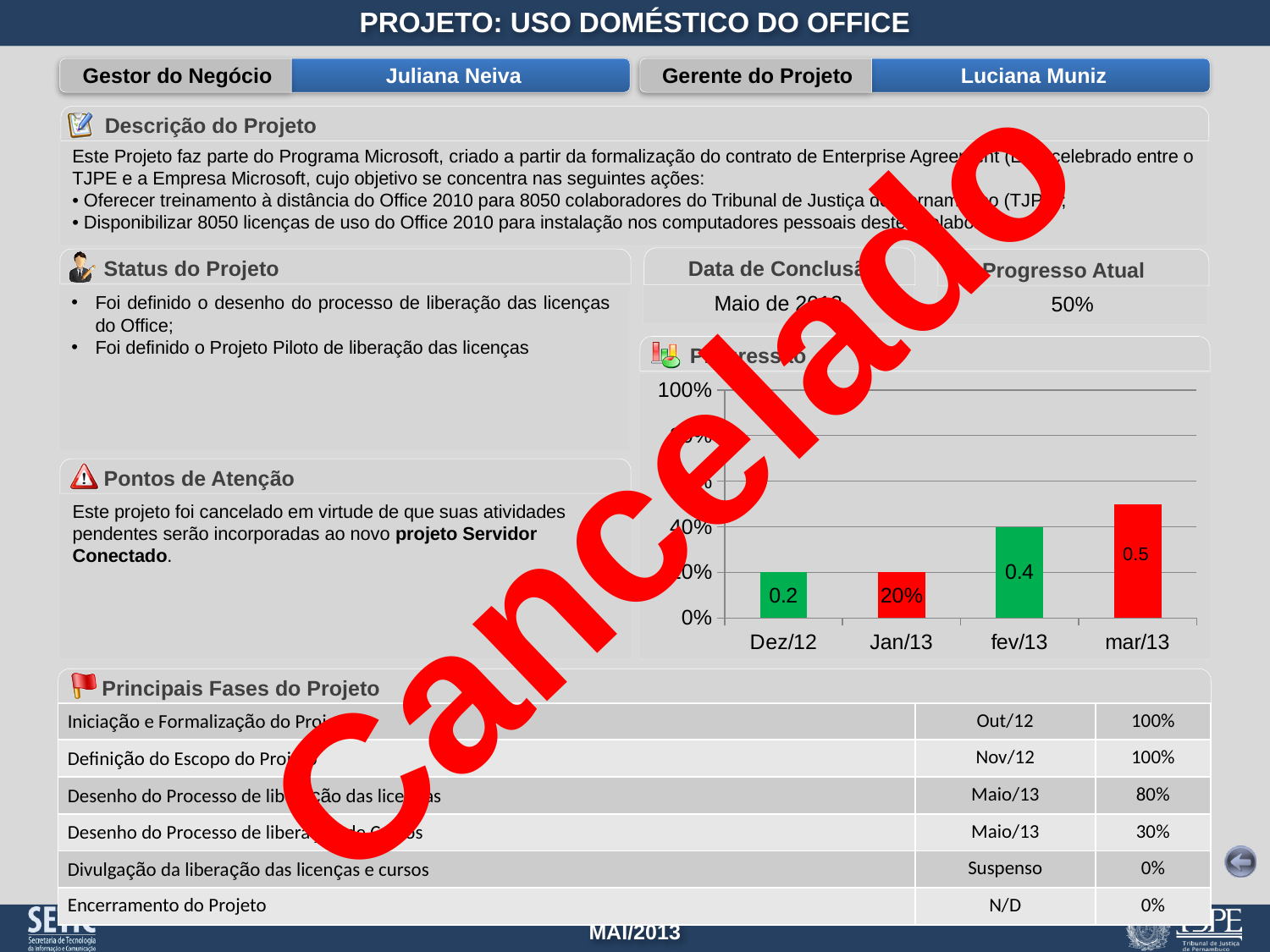
What is the difference between the values for mar/13 and fev/13 in the bar chart? 0.1 What is the value shown for Jan/13 in the bar chart? 20% Which is larger in the bar chart, the value for Dez/12 or the value for fev/13? fev/13 Which month has the highest bar in the chart? mar/13 What is the value shown for mar/13 in the bar chart? 0.5 What colour is the bar for mar/13? red What is the value shown for fev/13 in the bar chart? 0.4 How many months are shown on the x axis of the bar chart? 4 What kind of chart is shown on the slide? bar chart Is the value for mar/13 greater or less than 40%? greater Which is larger in the bar chart, the value for fev/13 or the value for mar/13? mar/13 What is the value shown for Dez/12 in the bar chart? 0.2